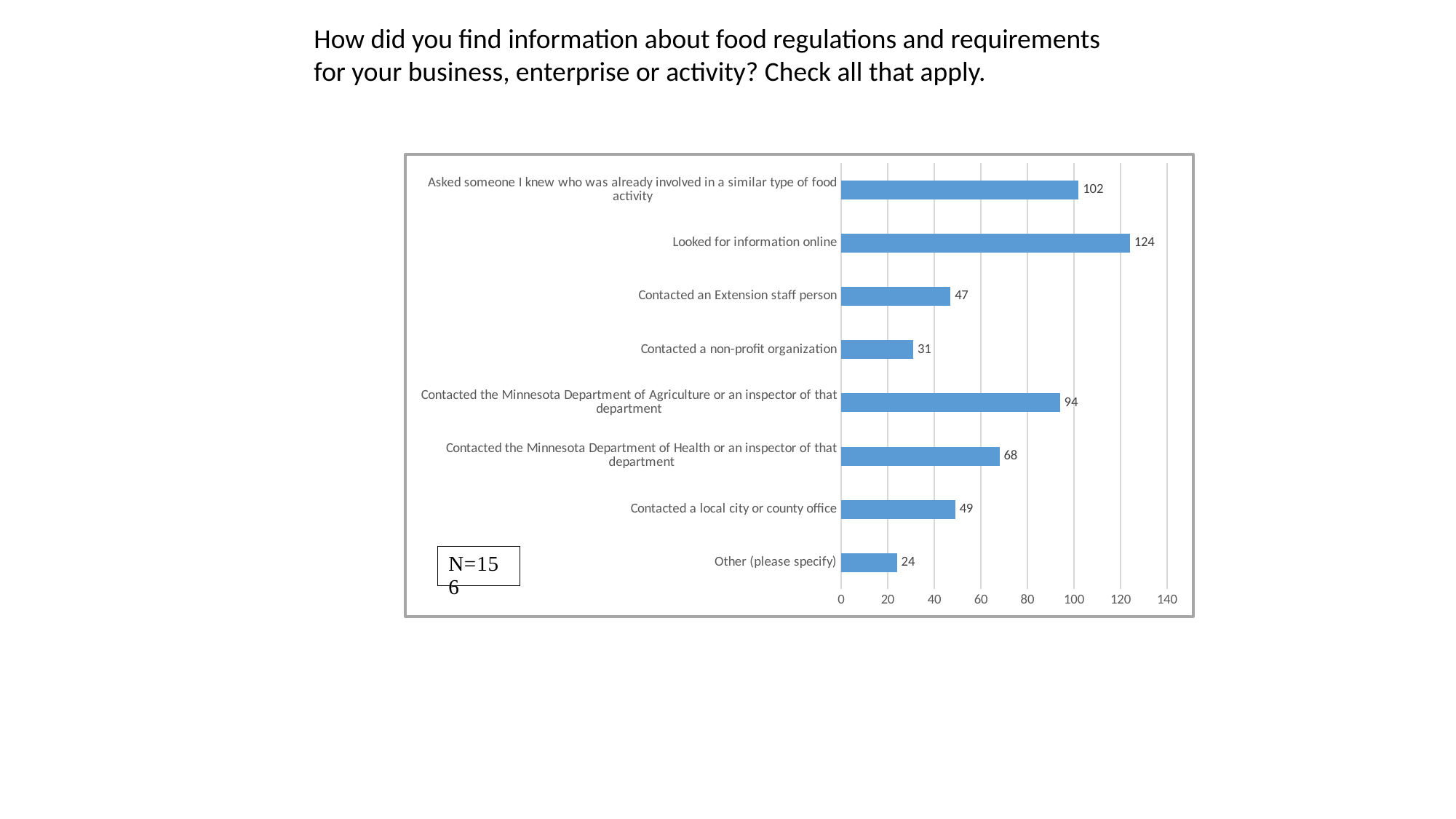
What is the difference between the values for "Looked for information online" and "Asked someone I knew who was already involved in a similar type of food activity"? 22 Which category has the highest value? Looked for information online What is the value for "Contacted a non-profit organization"? 31 What is the maximum value shown on the horizontal axis? 140 Which category has the lowest value? Other (please specify) What is the difference between the values for "Contacted the Minnesota Department of Agriculture or an inspector of that department" and "Contacted the Minnesota Department of Health or an inspector of that department"? 26 What is the value for "Contacted the Minnesota Department of Health or an inspector of that department"? 68 Which is larger: the value for "Contacted a local city or county office" or the value for "Contacted an Extension staff person"? Contacted a local city or county office Is the value for "Contacted the Minnesota Department of Agriculture or an inspector of that department" greater or less than 80? greater What kind of chart is shown on the slide? bar chart What is the value for "Looked for information online"? 124 How many categories are shown in the chart? 8